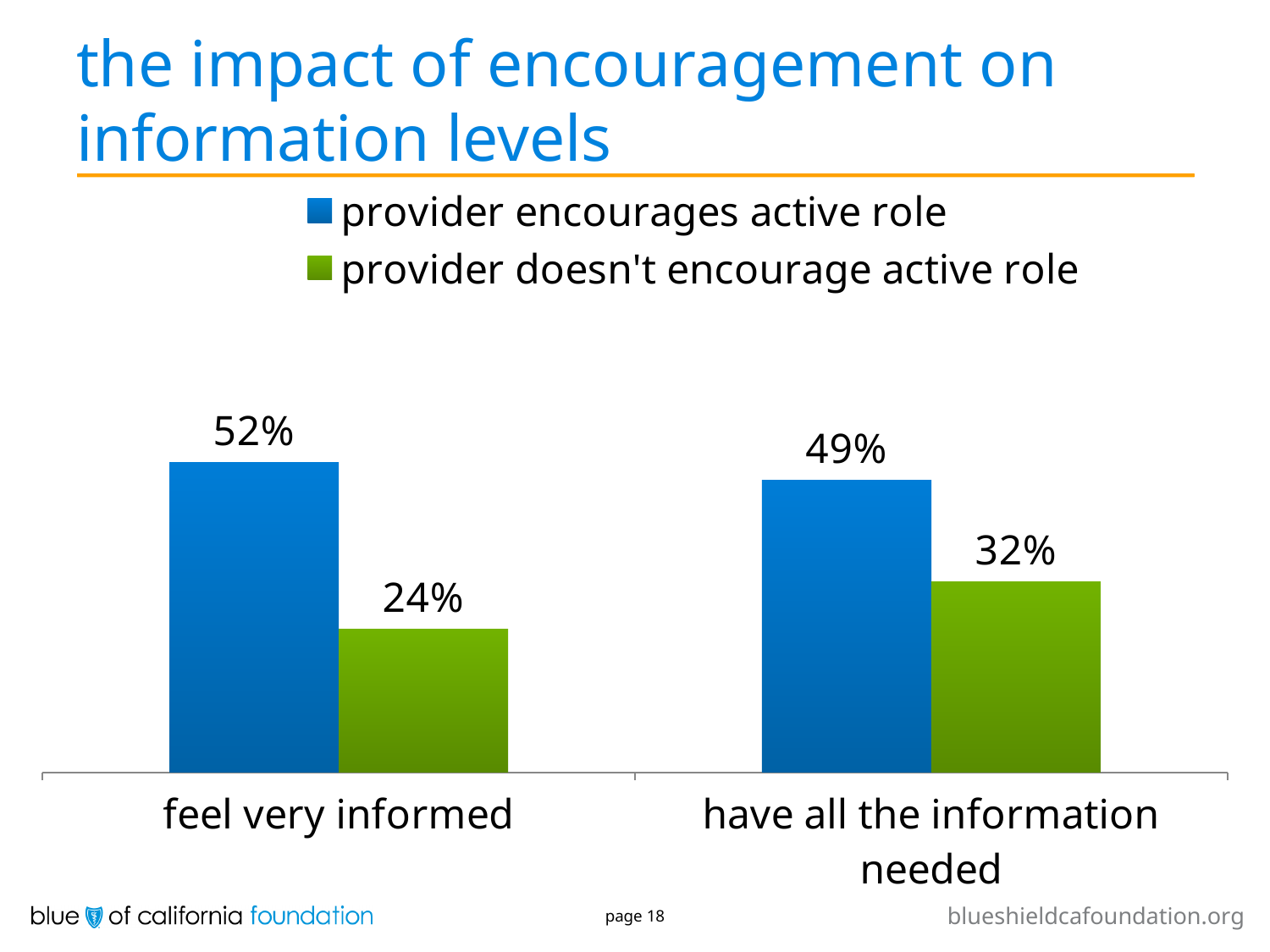
Which bar shows the lowest value on the chart? provider doesn't encourage active role, feel very informed What percentage of respondents whose provider doesn't encourage an active role feel very informed? 24% What kind of chart is shown on the slide? bar chart What percentage of respondents whose provider encourages an active role feel very informed? 52% How many categories are shown on the x axis? 2 What percentage of respondents whose provider doesn't encourage an active role have all the information needed? 32% For 'have all the information needed', which series has the larger value? provider encourages active role What percentage of respondents whose provider encourages an active role have all the information needed? 49% What is the difference between the two series for 'feel very informed'? 28% Which series has the highest value on the chart? provider encourages active role What is the difference between the two series for 'have all the information needed'? 17% How many series does the legend list? 2